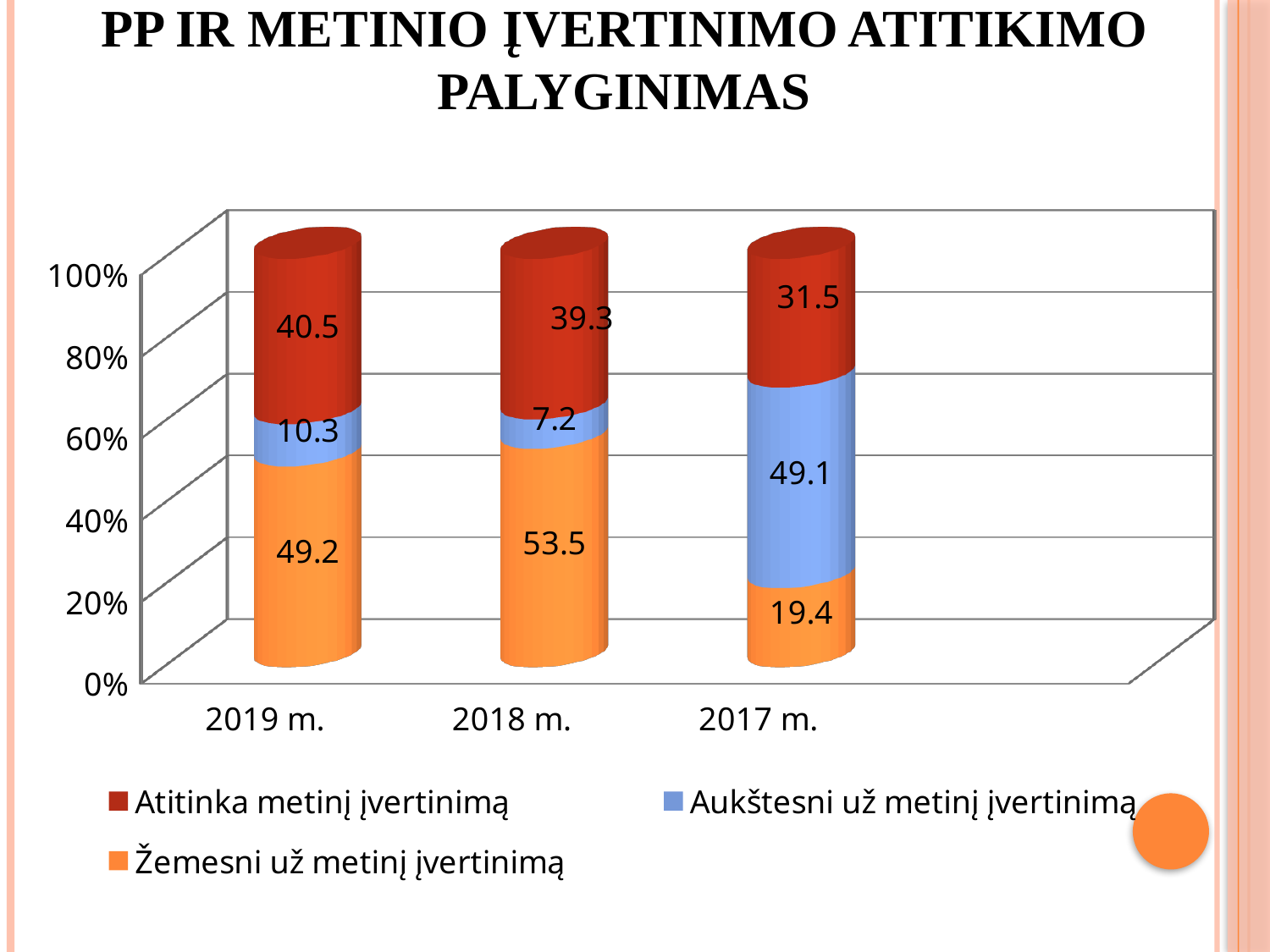
How many series does the legend list? 3 What is the value of "Atitinka metinį įvertinimą" for 2019 m.? 40.5 Which year has the highest value for "Žemesni už metinį įvertinimą"? 2018 m. What is the value of "Žemesni už metinį įvertinimą" for 2018 m.? 53.5 Which year has the lowest value for "Aukštesni už metinį įvertinimą"? 2018 m. How many years are shown on the x axis? 3 What kind of chart is shown on the slide? Stacked bar chart What is the difference between the "Atitinka metinį įvertinimą" values for 2019 m. and 2017 m.? 9 What is the value of "Aukštesni už metinį įvertinimą" for 2018 m.? 7.2 Which is larger: "Žemesni už metinį įvertinimą" for 2017 m. or "Aukštesni už metinį įvertinimą" for 2017 m.? Aukštesni už metinį įvertinimą Which series is shown in blue in the legend? Aukštesni už metinį įvertinimą What is the value of "Aukštesni už metinį įvertinimą" for 2017 m.? 49.1